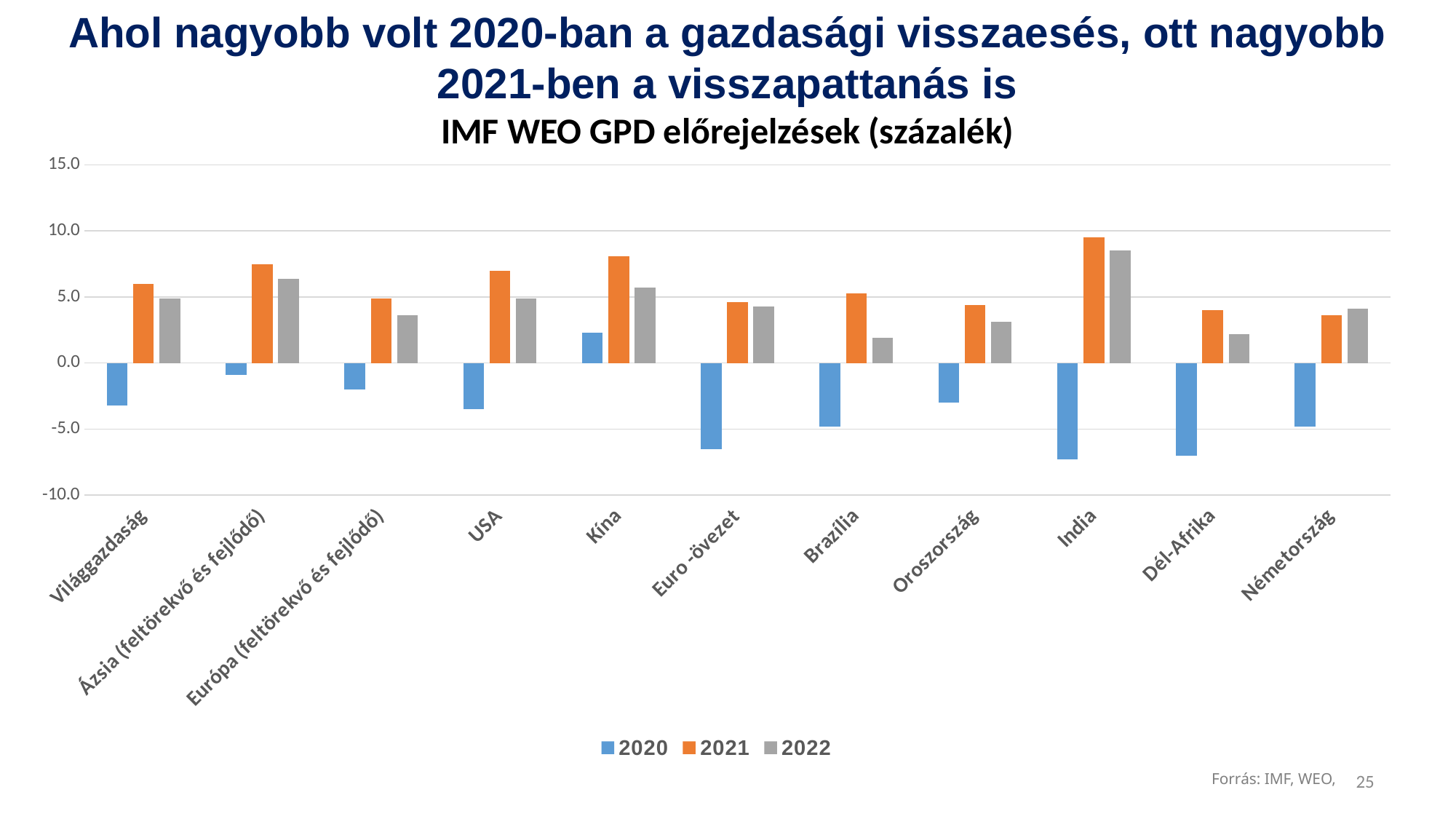
Is the 2020 value for USA greater or less than -5.0? greater What kind of chart is shown on the slide? bar chart Which country or region has the highest value for 2021? India How many countries or regions are shown on the x axis? 11 Is the 2022 value for Brazília greater or less than 5.0? less Which country or region has the highest value for 2022? India How many series does the legend list? 3 Which has the larger 2021 value, Kína or USA? Kína Is the 2021 value for Kína greater or less than 5.0? greater Which country or region has the highest value for 2020? Kína Which colour represents the 2021 series in the legend? orange